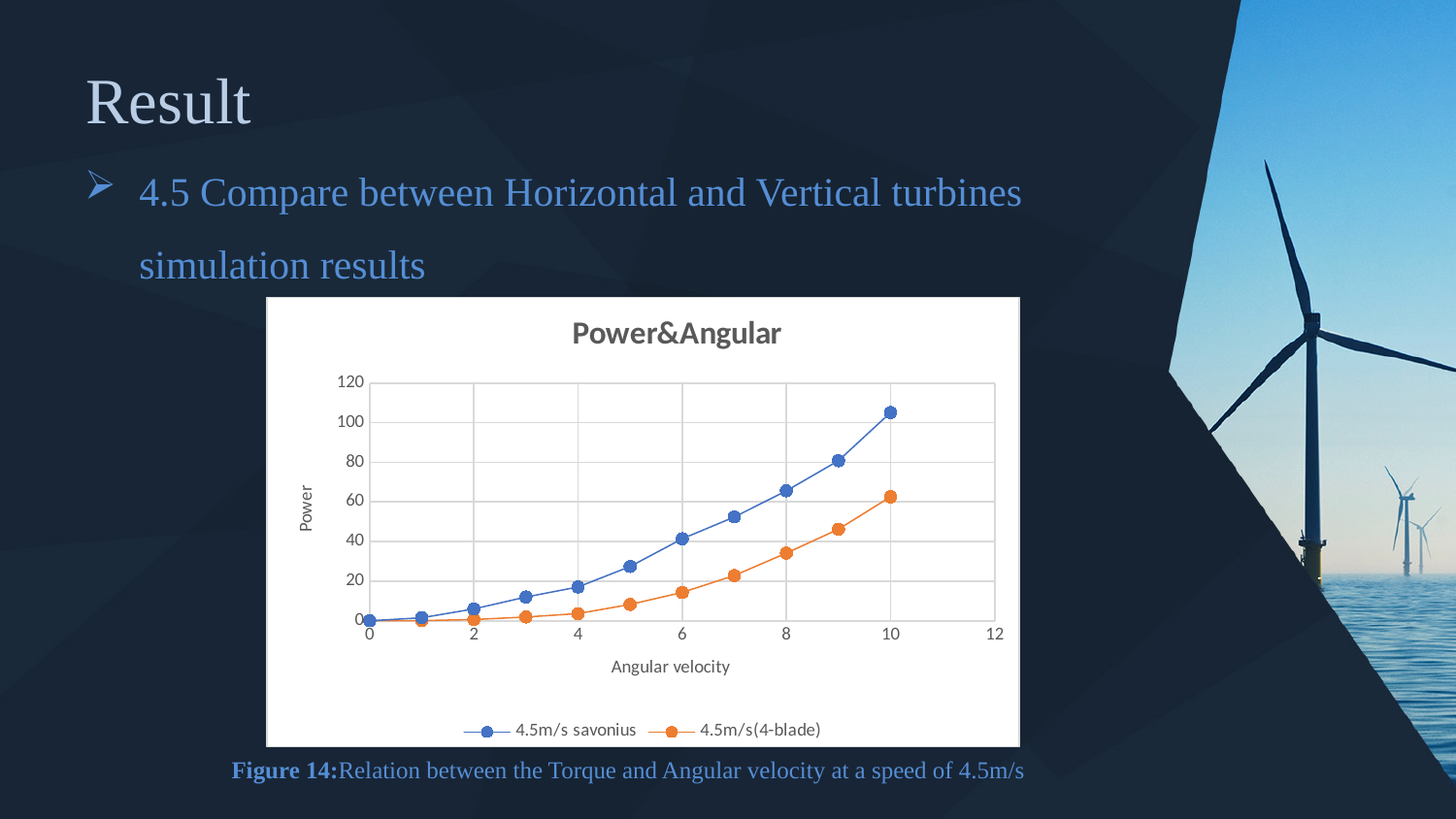
How many series does the chart legend list? 2 What is the title of the chart? Power&Angular Do the Power values for the 4.5m/s savonius series rise or fall as Angular velocity increases? rise Do the Power values for the 4.5m/s(4-blade) series rise or fall as Angular velocity increases? rise Is the Power value for 4.5m/s savonius at an Angular velocity of 8 greater or less than 60? greater At an Angular velocity of 10, which series has the higher Power, 4.5m/s savonius or 4.5m/s(4-blade)? 4.5m/s savonius How many data points are plotted for the 4.5m/s savonius series? 11 Is the Power value for 4.5m/s savonius at an Angular velocity of 10 greater or less than 100? greater Is the Power value for 4.5m/s(4-blade) at an Angular velocity of 8 greater or less than 40? less What kind of chart is shown on the slide? line chart What are the two series named in the legend? 4.5m/s savonius and 4.5m/s(4-blade)